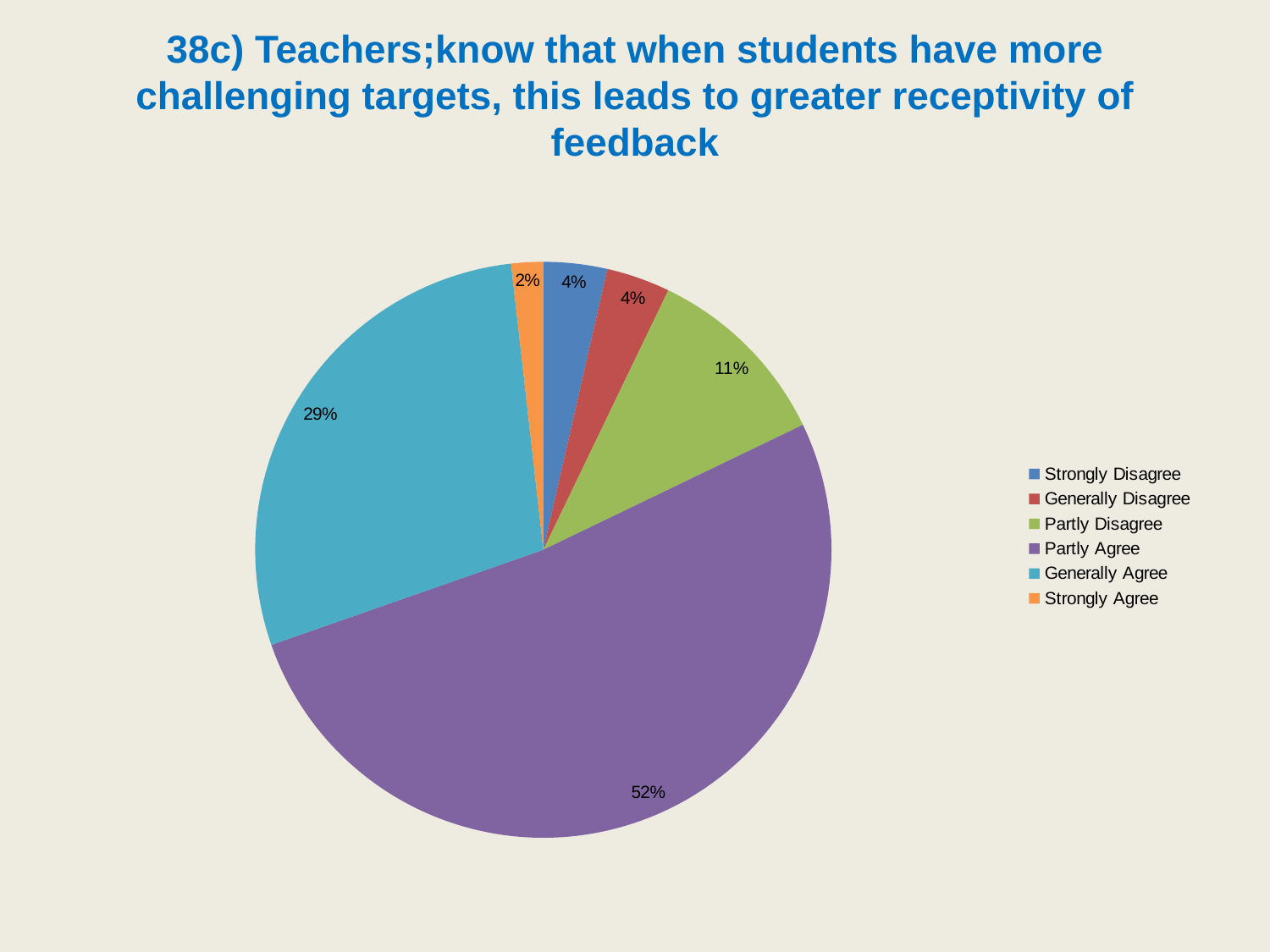
What kind of chart is shown on the slide? pie chart What percentage of respondents chose Generally Agree? 29% Which is larger, the share for Partly Disagree or the share for Generally Agree? Generally Agree What percentage of respondents chose Partly Agree? 52% How many response categories does the legend list? 6 Which response category has the largest share of the pie? Partly Agree What is the difference in percentage points between Partly Agree and Generally Agree? 23 What percentage of respondents chose Strongly Disagree? 4% What percentage of respondents chose Partly Disagree? 11% What colour is the Partly Agree slice? purple Which response category has the smallest share of the pie? Strongly Agree What percentage of respondents chose Strongly Agree? 2%